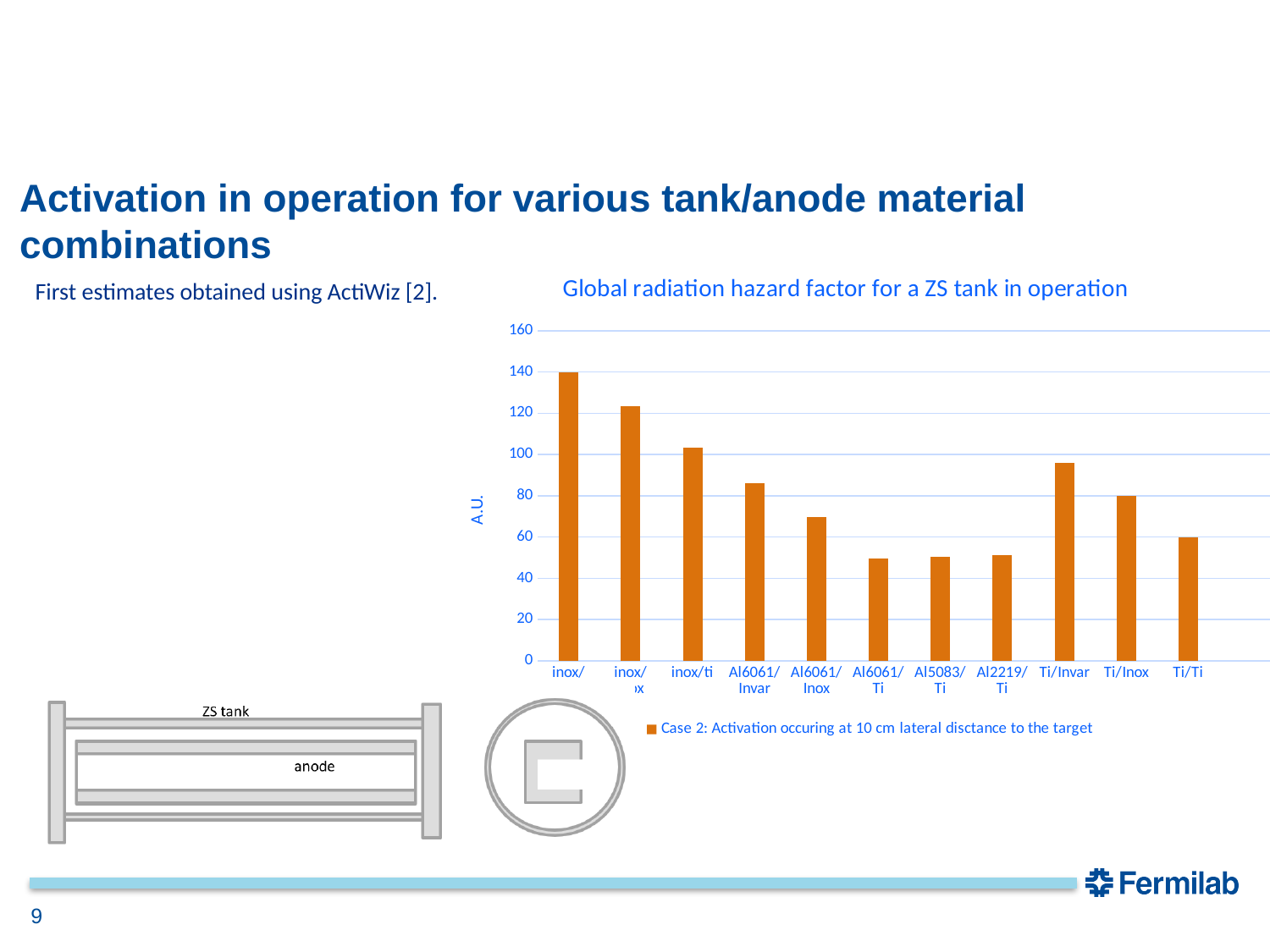
Is the value for Al6061/Inox greater or less than 80? less What kind of chart is shown on the slide? bar chart What is the label on the vertical axis of the chart? A.U. How many series does the chart legend list? 1 Is the value for Al6061/Invar greater or less than 80? greater How many bars (material combinations) are plotted in the chart? 11 What is the title of the chart? Global radiation hazard factor for a ZS tank in operation Which has the larger value, Al6061/Invar or Ti/Invar? Ti/Invar Is the value for Ti/Invar greater or less than 100? less Which has the larger value, Ti/Ti or Al6061/Ti? Ti/Ti